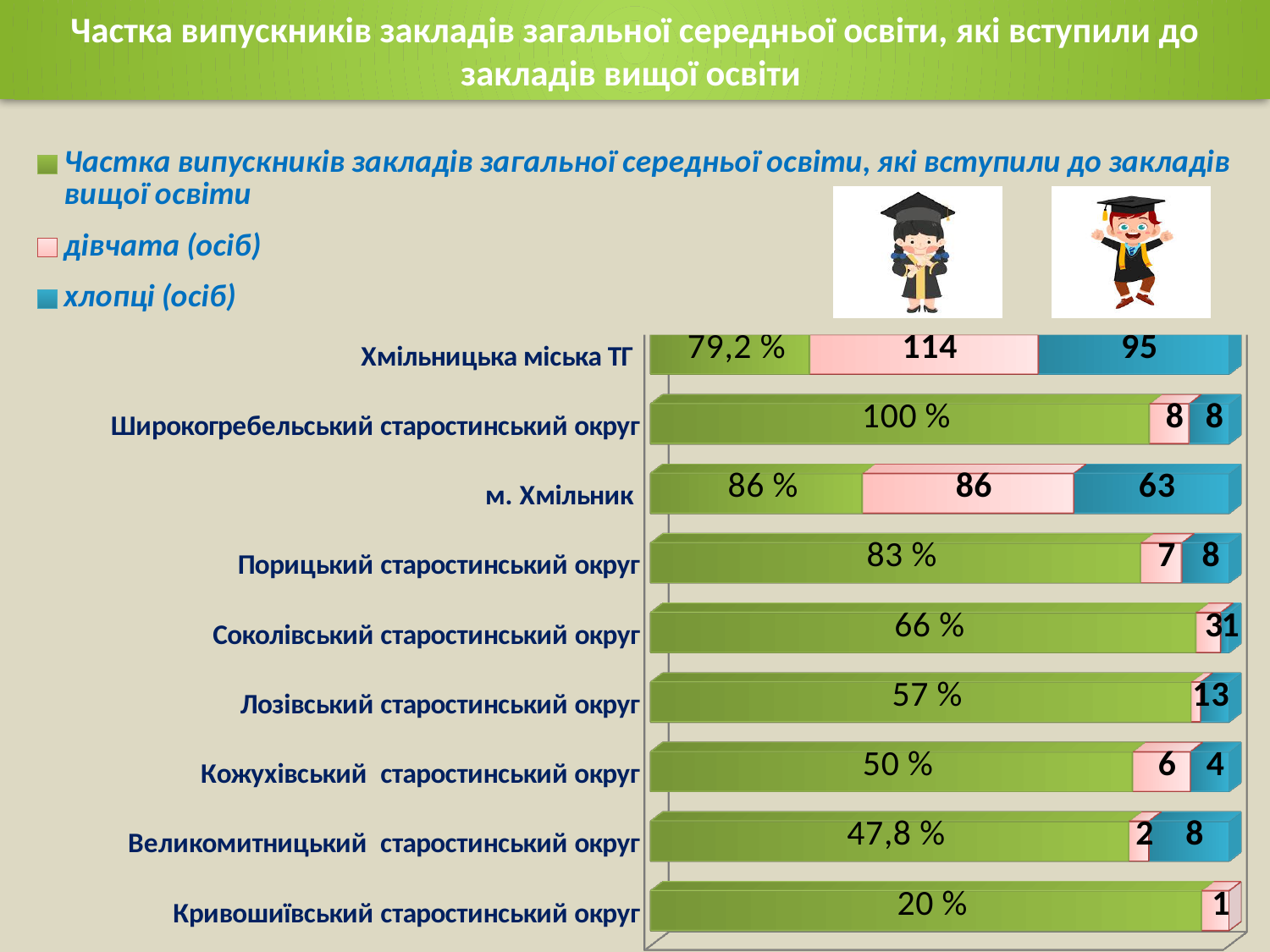
How many categories are shown on the chart? 9 What kind of chart is shown on the slide? bar chart What is the total number of girls and boys for Хмільницька міська ТГ? 209 For Великомитницький старостинський округ, which is larger: the number of girls or the number of boys? boys (хлопці) How many girls (дівчата) are shown for м. Хмільник? 86 How many series does the legend list? 3 How many boys (хлопці) are shown for Хмільницька міська ТГ? 95 What is the difference between the number of girls and the number of boys for м. Хмільник? 23 What is the difference between the number of girls and the number of boys for Хмільницька міська ТГ? 19 Which category has the lowest share of graduates who entered higher education institutions? Кривошиївський старостинський округ Which category has the highest share of graduates who entered higher education institutions? Широкогребельський старостинський округ What is the share of graduates who entered higher education institutions for Хмільницька міська ТГ? 79,2 %